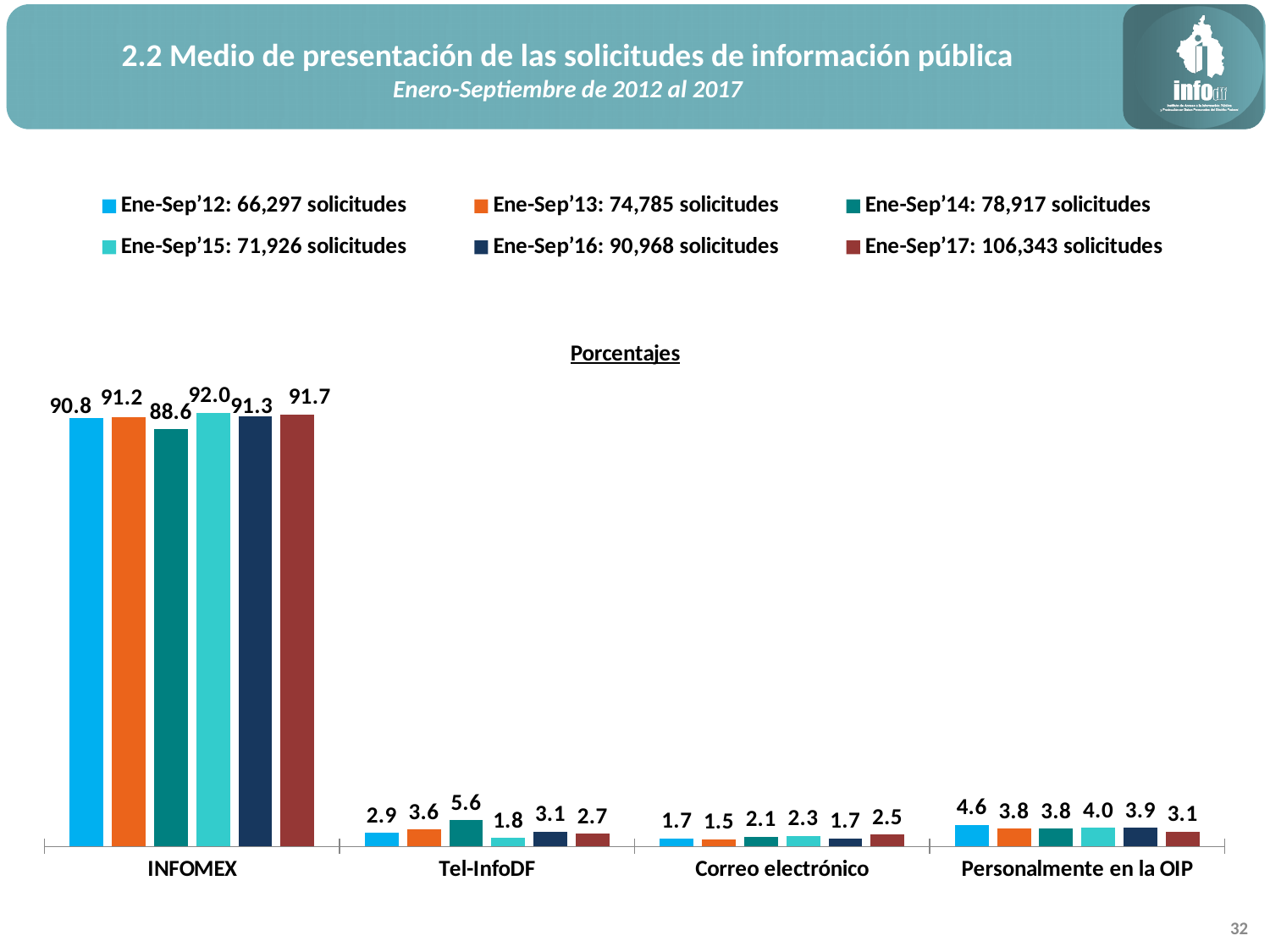
Which series has the highest value for Tel-InfoDF? Ene-Sep'14 What is the value for Correo electrónico in the Ene-Sep'17 series? 2.5 How many categories are shown on the x axis of the chart? 4 What is the value for Tel-InfoDF in the Ene-Sep'14 series? 5.6 What is the value for INFOMEX in the Ene-Sep'15 series? 92.0 How many series does the legend list? 6 Which series has the lowest value for INFOMEX? Ene-Sep'14 What is the difference between the Ene-Sep'15 and Ene-Sep'14 values for INFOMEX? 3.4 What kind of chart is shown on the slide? bar chart According to the legend, how many solicitudes were there in Ene-Sep'17? 106,343 solicitudes Which is larger for Personalmente en la OIP: the Ene-Sep'12 value or the Ene-Sep'17 value? Ene-Sep'12 What is the value for Personalmente en la OIP in the Ene-Sep'12 series? 4.6